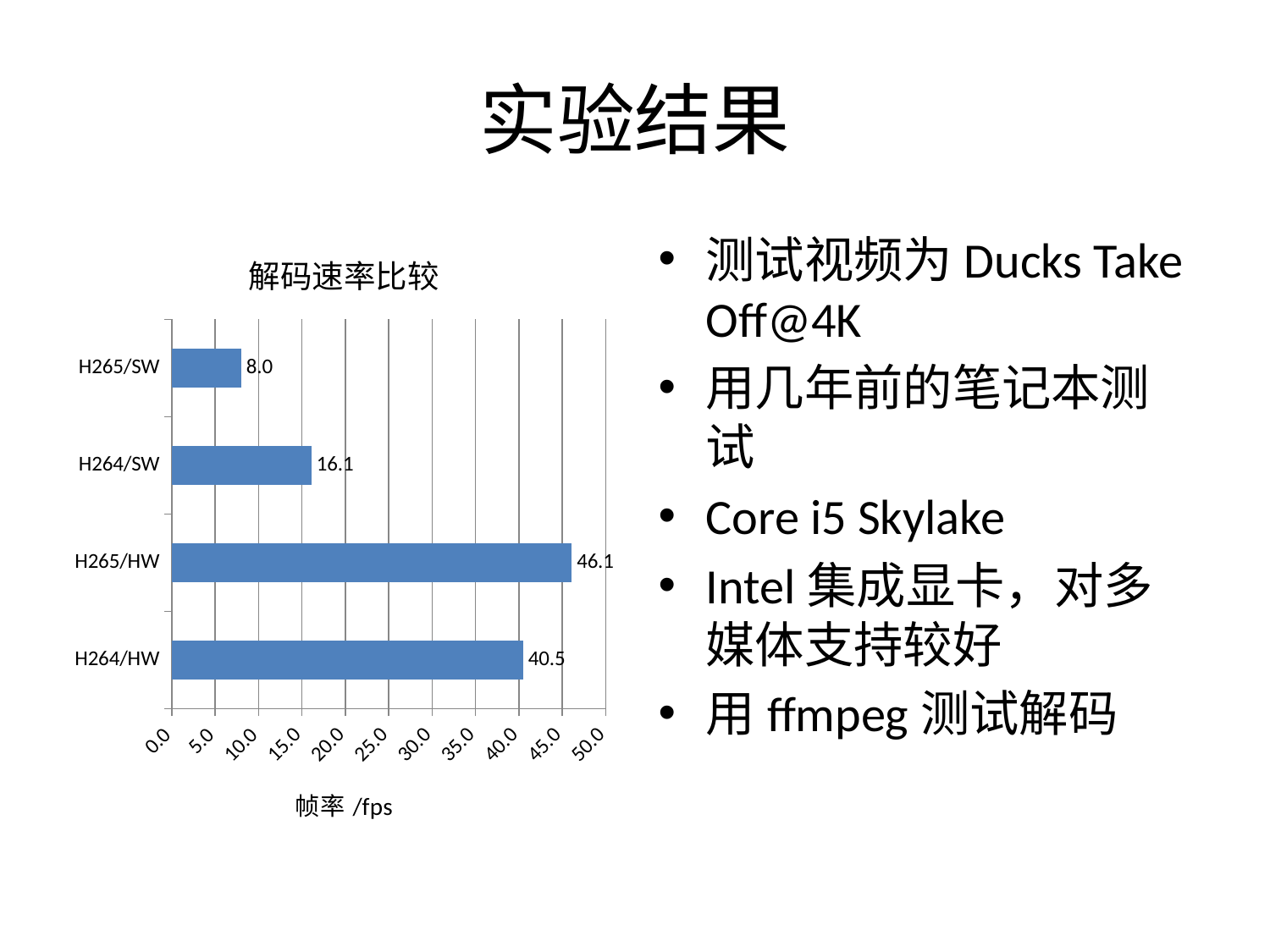
What is the difference between the values for H264/SW and H265/SW? 8.1 Which category has the lowest value? H265/SW What is the title of the chart? 解码速率比较 What is the value for H265/SW? 8.0 What is the value for H264/HW? 40.5 Which category has the highest value? H265/HW What kind of chart is shown on the slide? bar chart Which is larger, the value for H264/SW or the value for H265/SW? H264/SW What is the difference between the values for H265/HW and H264/HW? 5.6 What is the value for H265/HW? 46.1 How many categories are shown in the chart? 4 What is the value for H264/SW? 16.1